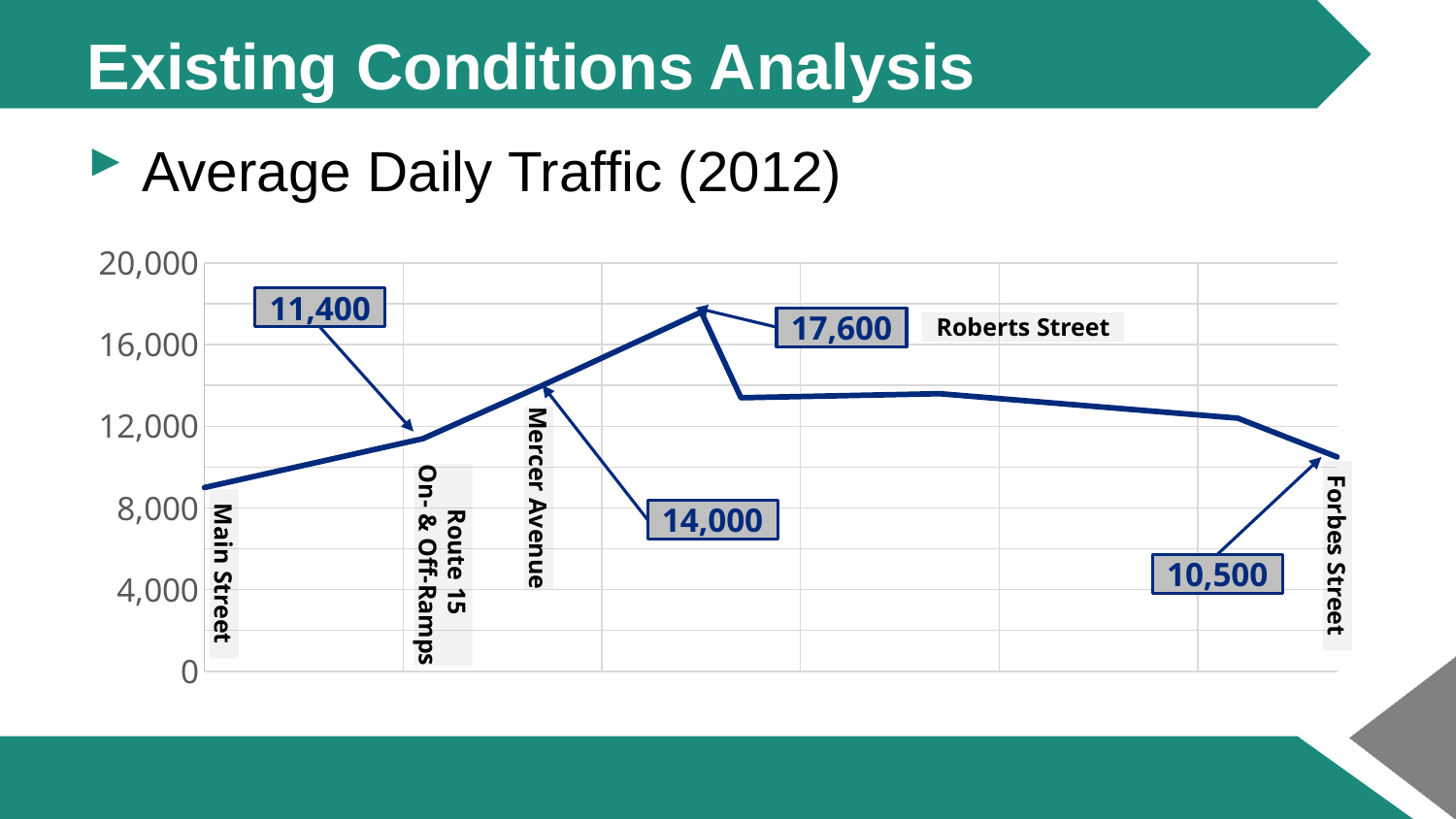
What is the average daily traffic at the Route 15 On- & Off-Ramps? 11,400 What is the difference between the labeled values at Roberts Street and Forbes Street? 7,100 What kind of chart is shown on the slide? line chart What is the average daily traffic value labeled at Forbes Street? 10,500 Which of the labeled values on the chart is the lowest? 10,500 (Forbes Street) What is the average daily traffic value labeled at Roberts Street? 17,600 What is the difference between the labeled values at Roberts Street and Mercer Avenue? 3,600 Which location has the highest average daily traffic on the chart? Roberts Street Is the average daily traffic at Main Street greater or less than 12,000? less What is the average daily traffic value labeled at Mercer Avenue? 14,000 Does the traffic rise or fall along the line from Roberts Street to Forbes Street? fall Which has higher average daily traffic, Mercer Avenue or the Route 15 On- & Off-Ramps? Mercer Avenue